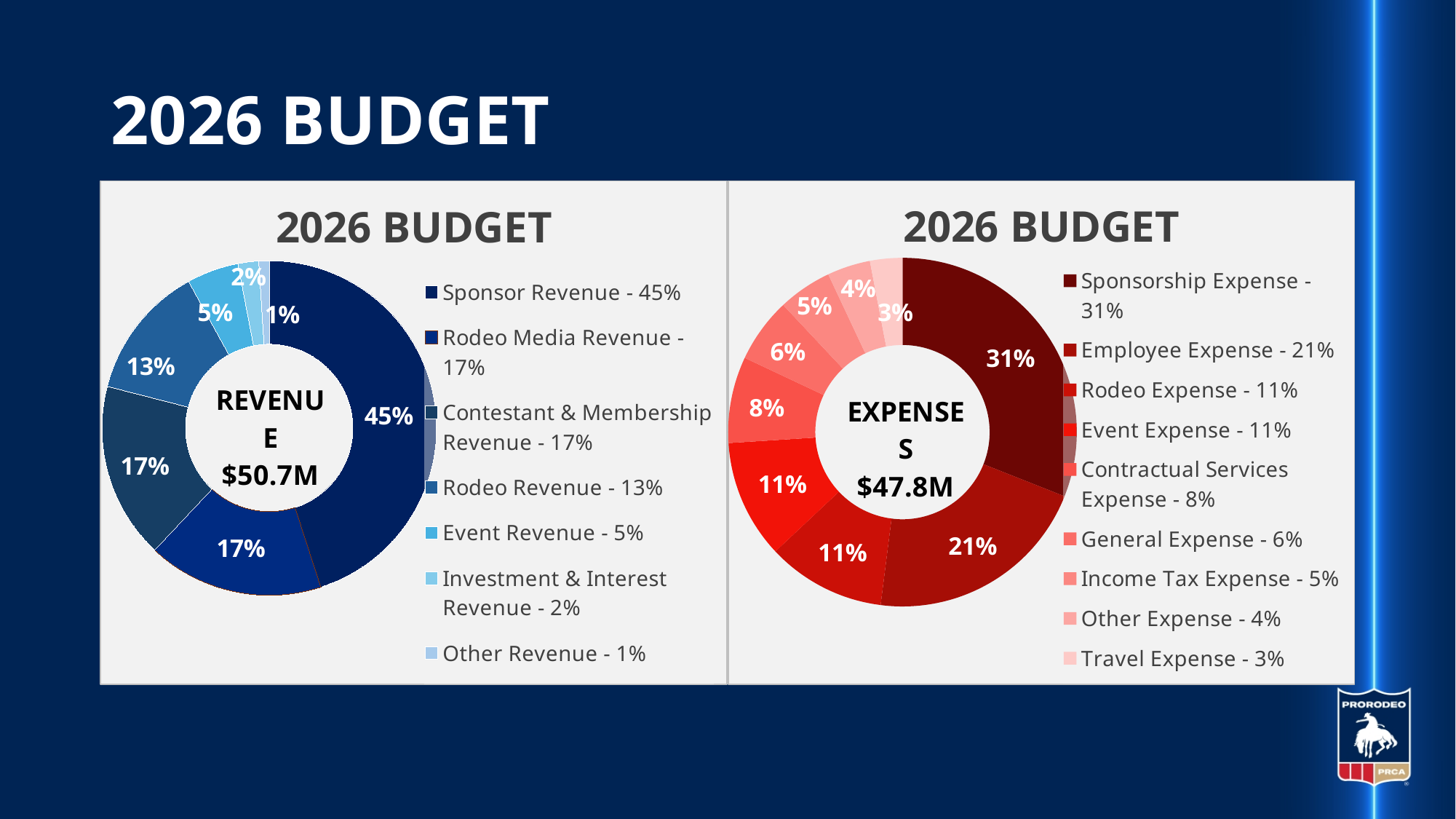
On the right (Expenses) chart, which category has the smallest share? Travel Expense On the left (Revenue) chart, which category has the largest share? Sponsor Revenue What total amount is shown in the center of the right (Expenses) chart? $47.8M On the left (Revenue) chart, which category has the smallest share? Other Revenue On the right (Expenses) chart, what share does Contractual Services Expense have? 8% On the right (Expenses) chart, which category has the largest share? Sponsorship Expense On the right (Expenses) chart, what share does Employee Expense have? 21% What kind of chart is the left (Revenue) chart? Doughnut chart How many categories does the legend of the right (Expenses) chart list? 9 On the right (Expenses) chart, which is larger: General Expense or Income Tax Expense? General Expense On the left (Revenue) chart, what is the difference between the Sponsor Revenue share and the Rodeo Revenue share? 32% On the left (Revenue) chart, what share does Sponsor Revenue have? 45%